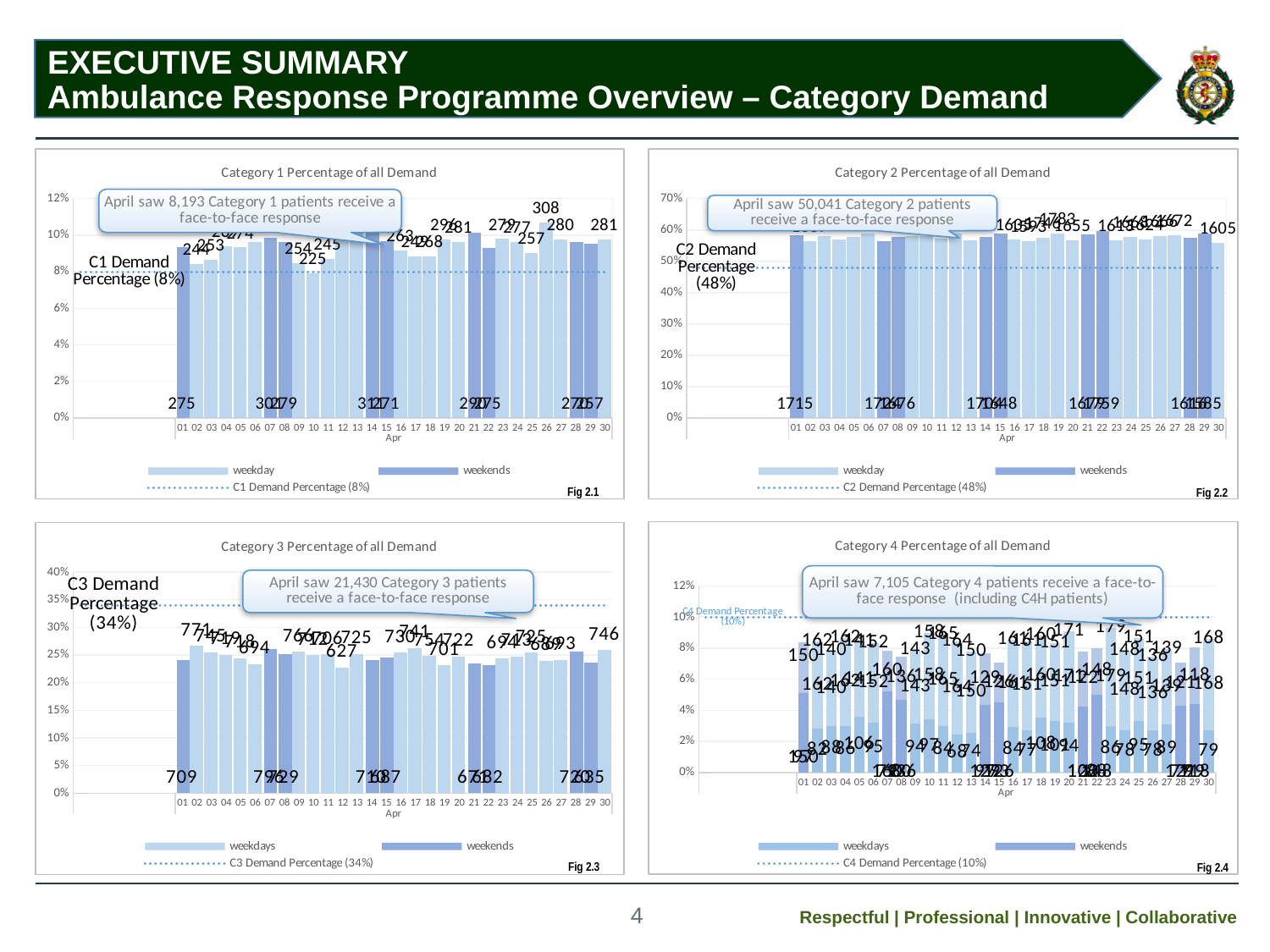
How many days are plotted along the x axis of the 'Category 3 Percentage of all Demand' chart? 30 In the 'Category 3 Percentage of all Demand' chart, what is the data label on the bar for 30 Apr? 746 In the 'Category 2 Percentage of all Demand' chart, what value does the dotted C2 Demand Percentage reference line represent? 48% In the 'Category 3 Percentage of all Demand' chart, what is the data label on the bar for 01 Apr? 709 How many entries does the legend of the 'Category 2 Percentage of all Demand' chart list? 3 In the 'Category 2 Percentage of all Demand' chart, what is the data label on the bar for 01 Apr? 1715 What kind of chart is the 'Category 1 Percentage of all Demand' chart? bar chart In the 'Category 2 Percentage of all Demand' chart, is the value for 15 Apr greater or less than 50%? greater In the 'Category 3 Percentage of all Demand' chart, is the value for 10 Apr greater or less than 30%? less In the 'Category 2 Percentage of all Demand' chart, what is the data label on the bar for 30 Apr? 1605 In the 'Category 1 Percentage of all Demand' chart, how many Category 1 patients did April see receive a face-to-face response, according to the callout? 8,193 In the 'Category 4 Percentage of all Demand' chart, how many Category 4 patients did April see receive a face-to-face response, according to the callout? 7,105